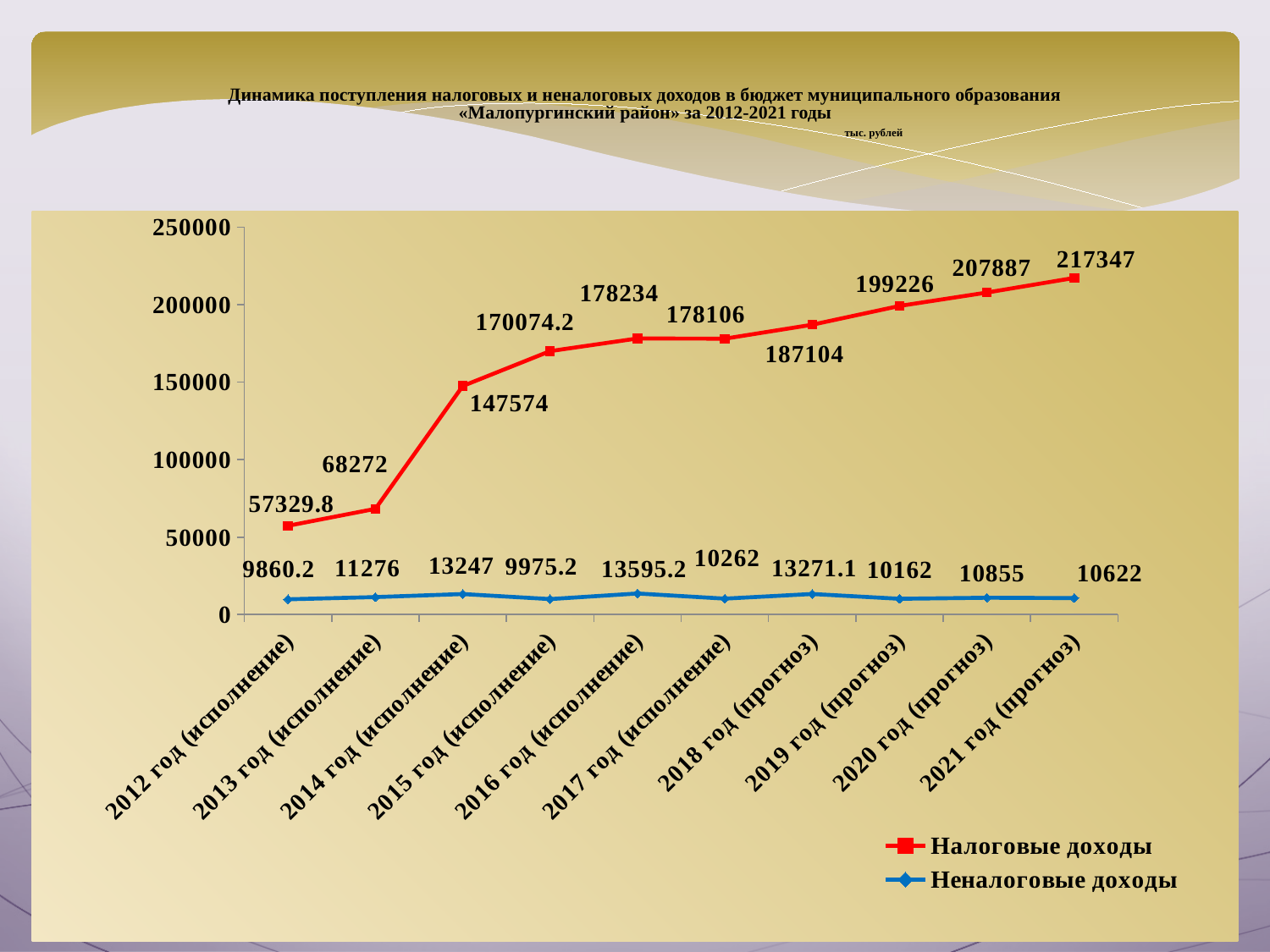
In which year is Налоговые доходы the lowest? 2012 год (исполнение) What is the value of Налоговые доходы for 2014 год (исполнение)? 147574 Which is larger: Налоговые доходы in 2016 год (исполнение) or in 2017 год (исполнение)? 2016 год (исполнение) How many series does the legend list? 2 What is the value of Неналоговые доходы for 2016 год (исполнение)? 13595.2 What is the value of Налоговые доходы for 2021 год (прогноз)? 217347 How many years (categories) are plotted on the x axis? 10 What is the difference between Налоговые доходы in 2021 год (прогноз) and 2020 год (прогноз)? 9460 What colour is the line for Неналоговые доходы? blue In which year is Неналоговые доходы the highest? 2016 год (исполнение) What type of chart is shown on the slide? line chart Do the values of Налоговые доходы generally rise or fall from 2012 to 2021? rise